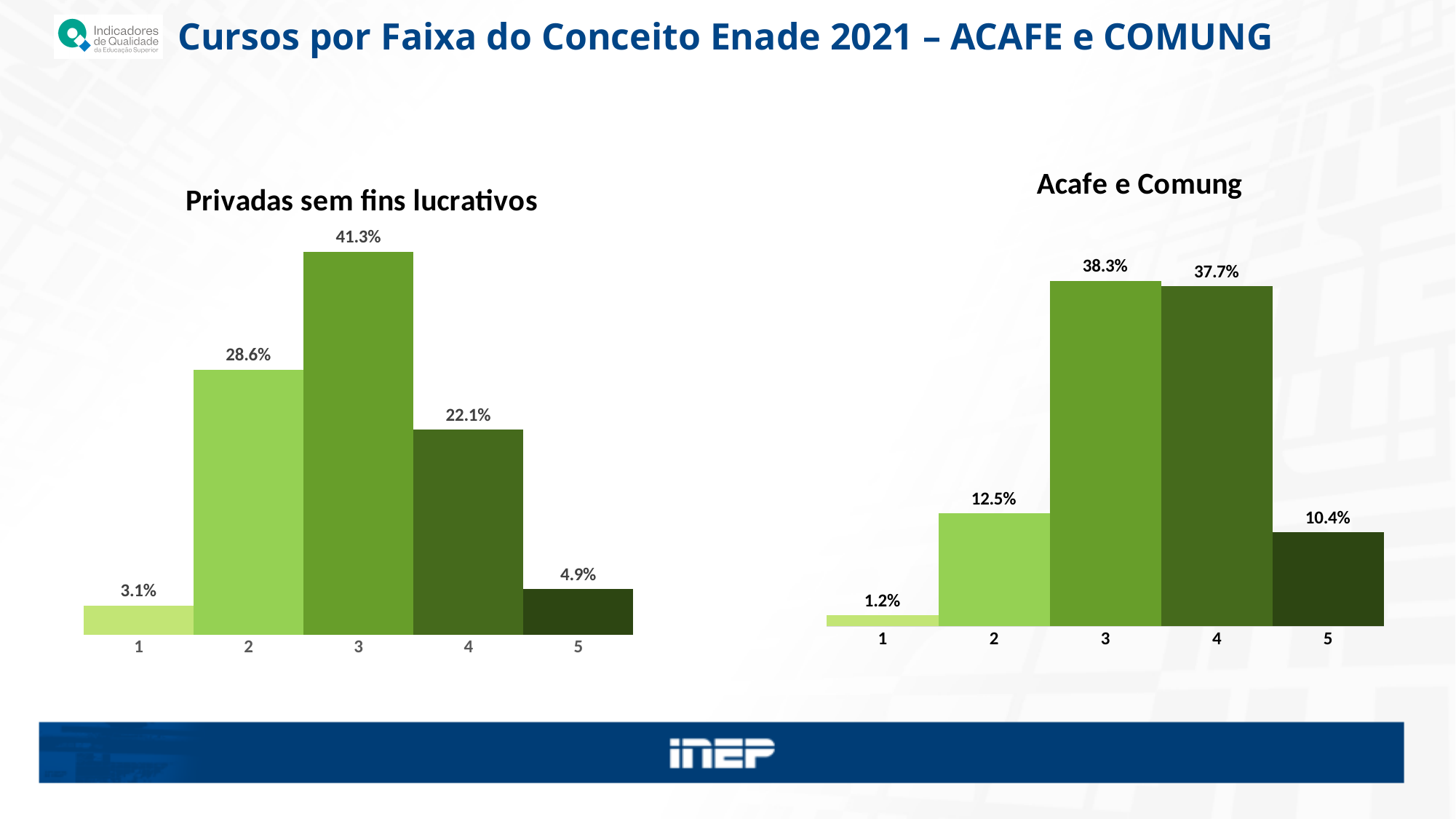
In the 'Acafe e Comung' chart, what is the difference between the values for category 3 and category 4? 0.6% In the 'Acafe e Comung' chart, what is the value for category 5? 10.4% In the 'Acafe e Comung' chart, what is the value for category 2? 12.5% In the 'Privadas sem fins lucrativos' chart, what is the difference between the values for category 2 and category 4? 6.5% What is the title of the chart on the left side of the slide? Privadas sem fins lucrativos In the 'Privadas sem fins lucrativos' chart, which category has the highest value? 3 How many categories are shown in the 'Privadas sem fins lucrativos' chart? 5 In the 'Privadas sem fins lucrativos' chart, what is the value for category 1? 3.1% In the 'Privadas sem fins lucrativos' chart, what is the value for category 3? 41.3% In the 'Acafe e Comung' chart, which is larger: the value for category 2 or the value for category 5? 2 In the 'Acafe e Comung' chart, which category has the lowest value? 1 What kind of chart is the 'Acafe e Comung' chart? Bar chart